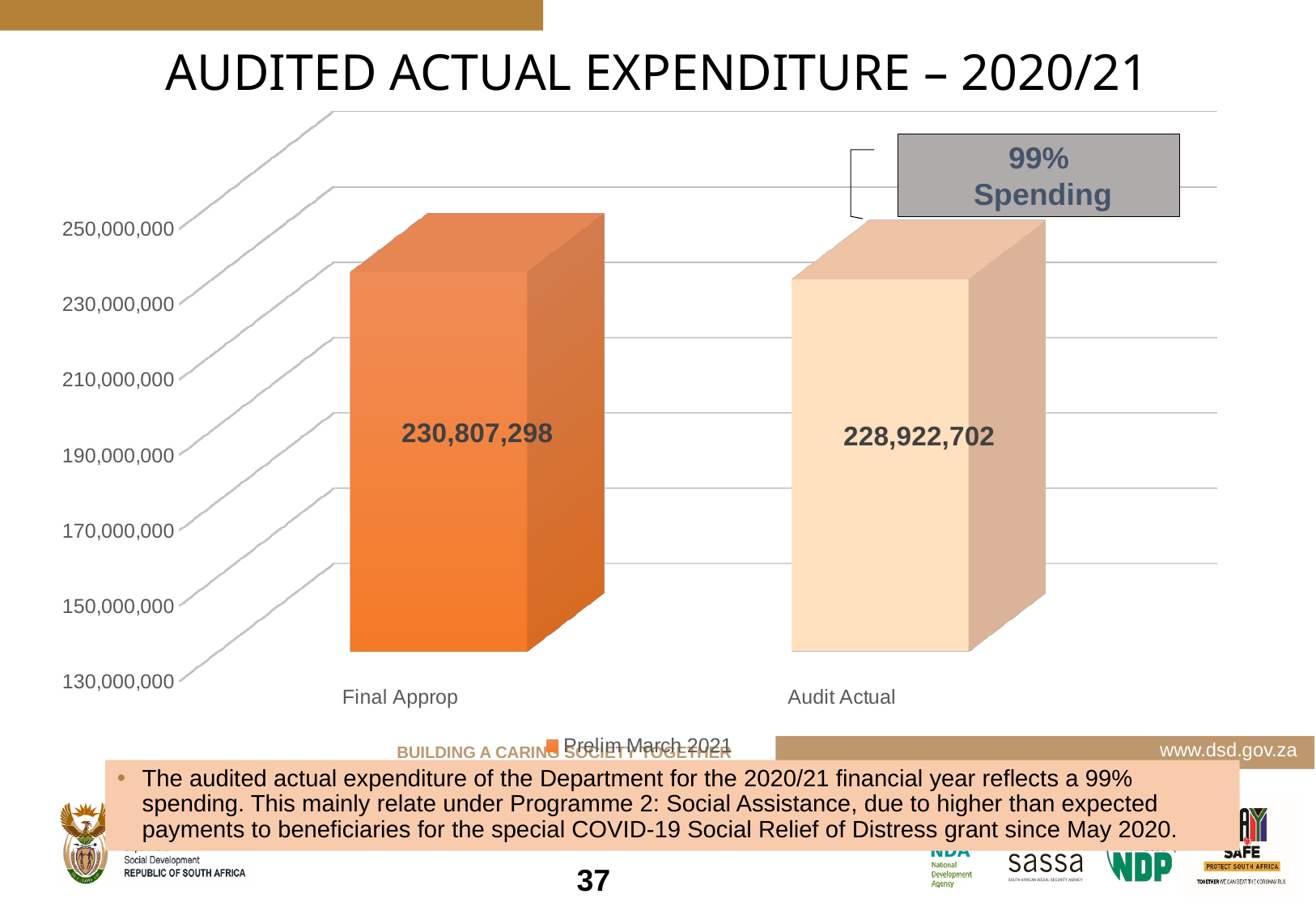
Is the value for Audit Actual greater or less than 210,000,000? greater How many categories are shown on the x axis? 2 Which category has the highest value? Final Approp Which category has the higher value, Final Approp or Audit Actual? Final Approp What is the difference between the Final Approp value and the Audit Actual value? 1,884,596 What is the value for Audit Actual? 228,922,702 What is the value for Final Approp? 230,807,298 What is the title of the chart on the slide? AUDITED ACTUAL EXPENDITURE – 2020/21 What percentage of spending does the callout box above the Audit Actual bar show? 99% Spending Is the value for Final Approp greater or less than 250,000,000? less Which category has the lowest value? Audit Actual What kind of chart is shown on the slide? Bar chart